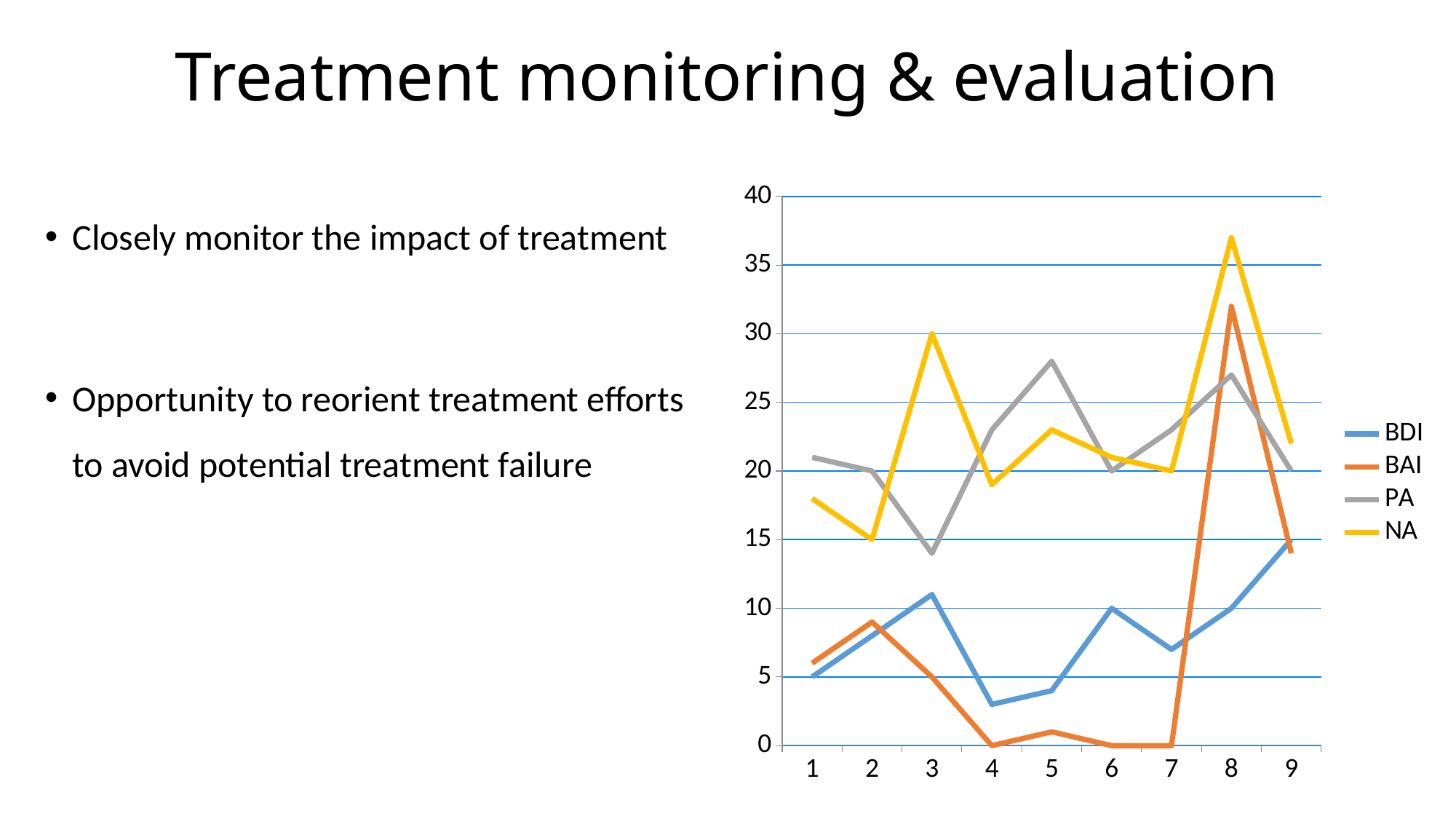
Which series has the highest value at point 8? NA What is the value of BAI at point 4? 0 Is the value for BAI at point 8 greater or less than 30? greater What are the entries listed in the legend? BDI, BAI, PA, NA Which series has the lowest value at point 3? BAI How many points are there along the x axis? 9 What kind of chart is shown on the slide? line chart How many series does the legend list? 4 Is the value for PA at point 3 greater or less than 15? less At point 5, which is larger, PA or NA? PA What is the value of NA at point 3? 30 Is the value for NA at point 8 greater or less than 35? greater